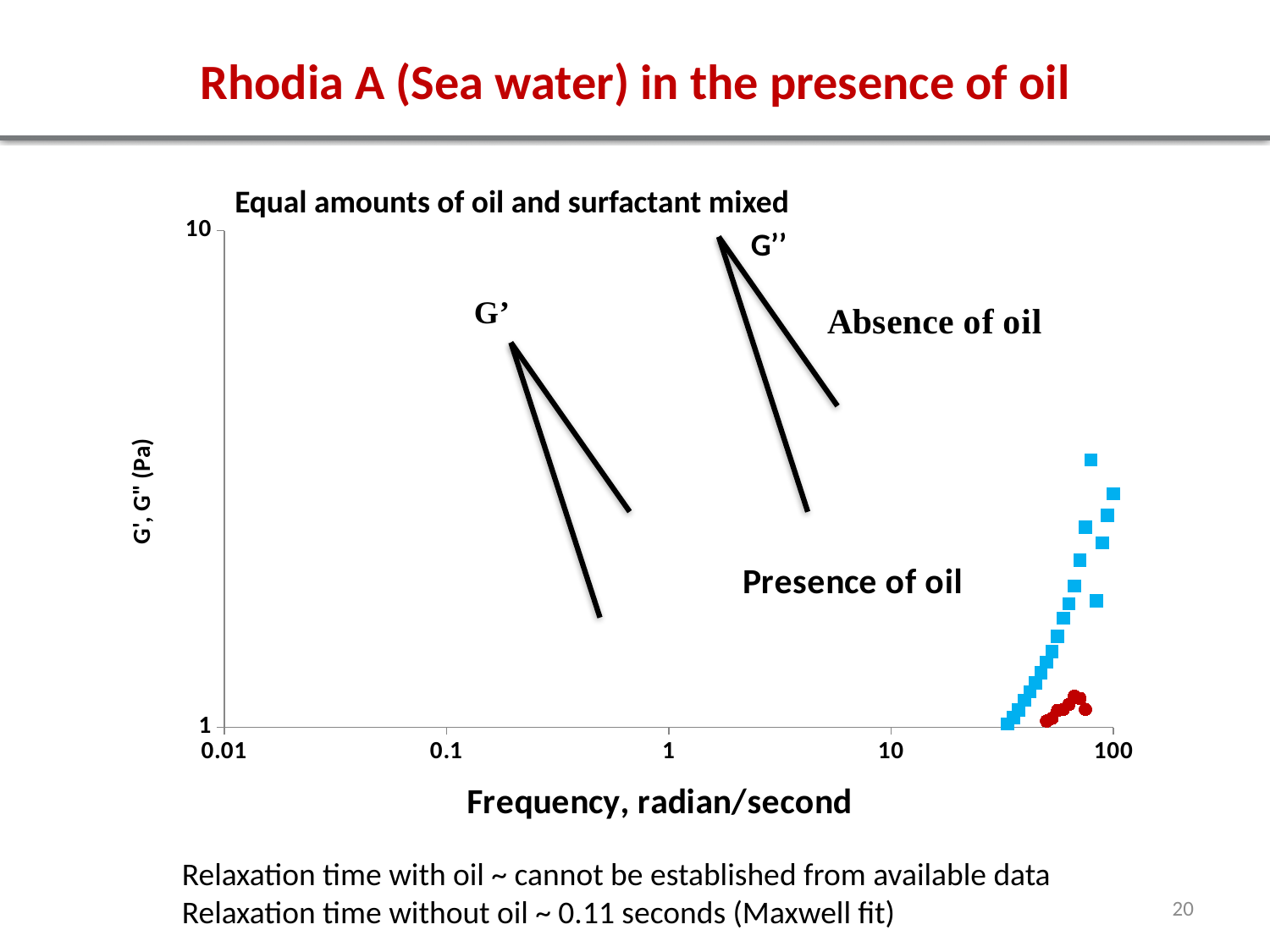
Which series reaches the highest value on the chart, the blue squares or the red circles? blue squares What is the label of the x axis of the chart? Frequency, radian/second Are the red circle data points greater or less than 10 Pa? less Is the highest value of the blue square series greater or less than 10 Pa? less What is the title of the chart? Equal amounts of oil and surfactant mixed Near 100 radian/second, which series has the larger values: the blue squares or the red circles? blue squares Is the highest value of the blue square series greater or less than 1 Pa? greater What kind of chart is shown on the slide? scatter chart Do the blue square data points rise or fall as frequency increases along the x axis? rise